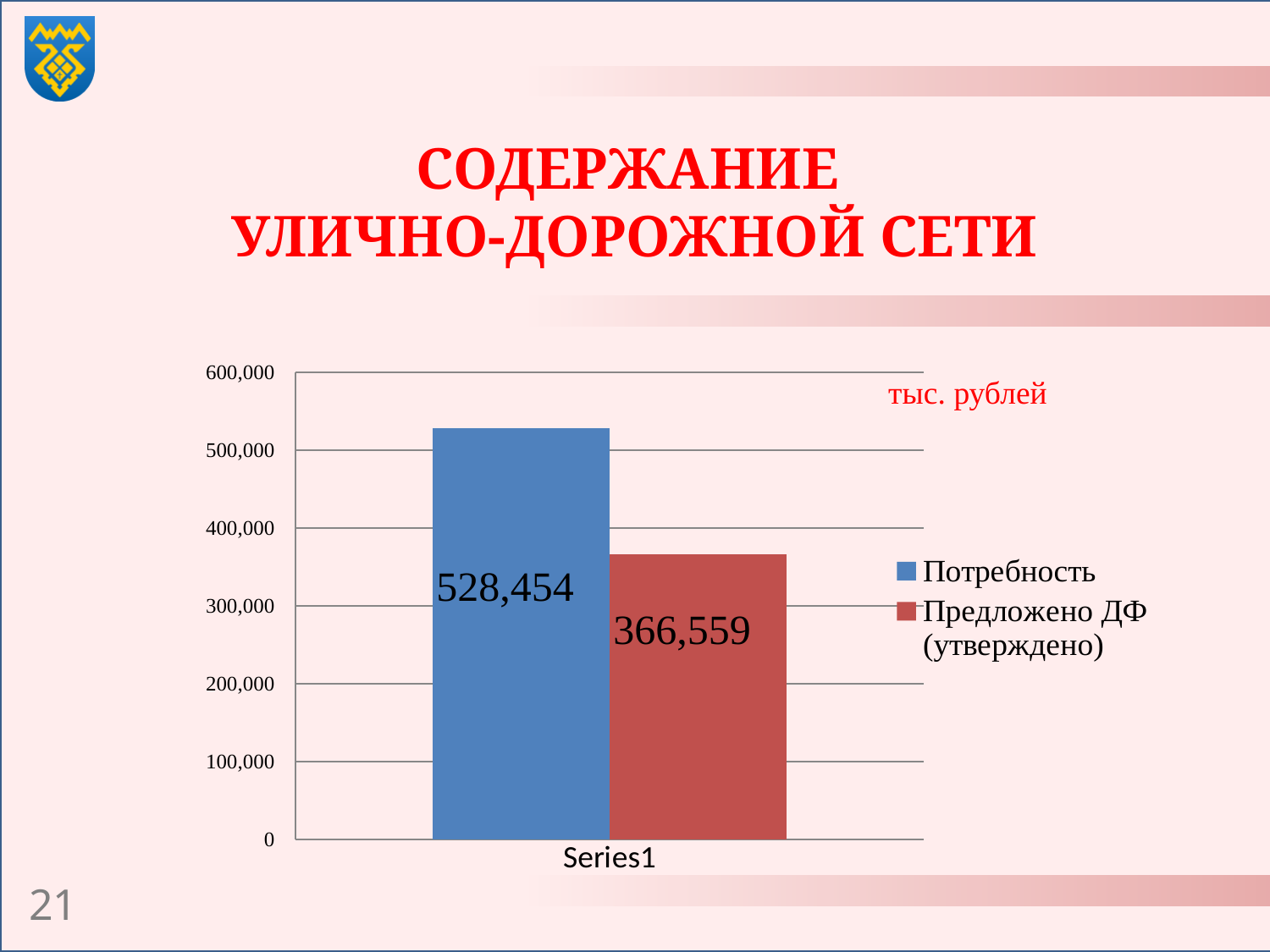
Which series has the higher value, Потребность or Предложено ДФ (утверждено)? Потребность Which series has the lowest value? Предложено ДФ (утверждено) What is the value for Потребность? 528,454 What is the category label shown on the x axis? Series1 How many series does the legend list? 2 What is the value for Предложено ДФ (утверждено)? 366,559 What kind of chart is shown on the slide? bar chart What unit is indicated for the values in the chart? тыс. рублей What colour is the bar for Потребность? blue What is the difference between the Потребность value and the Предложено ДФ (утверждено) value? 161,895 Is the value for Потребность greater or less than 500,000? greater Is the value for Предложено ДФ (утверждено) greater or less than 400,000? less